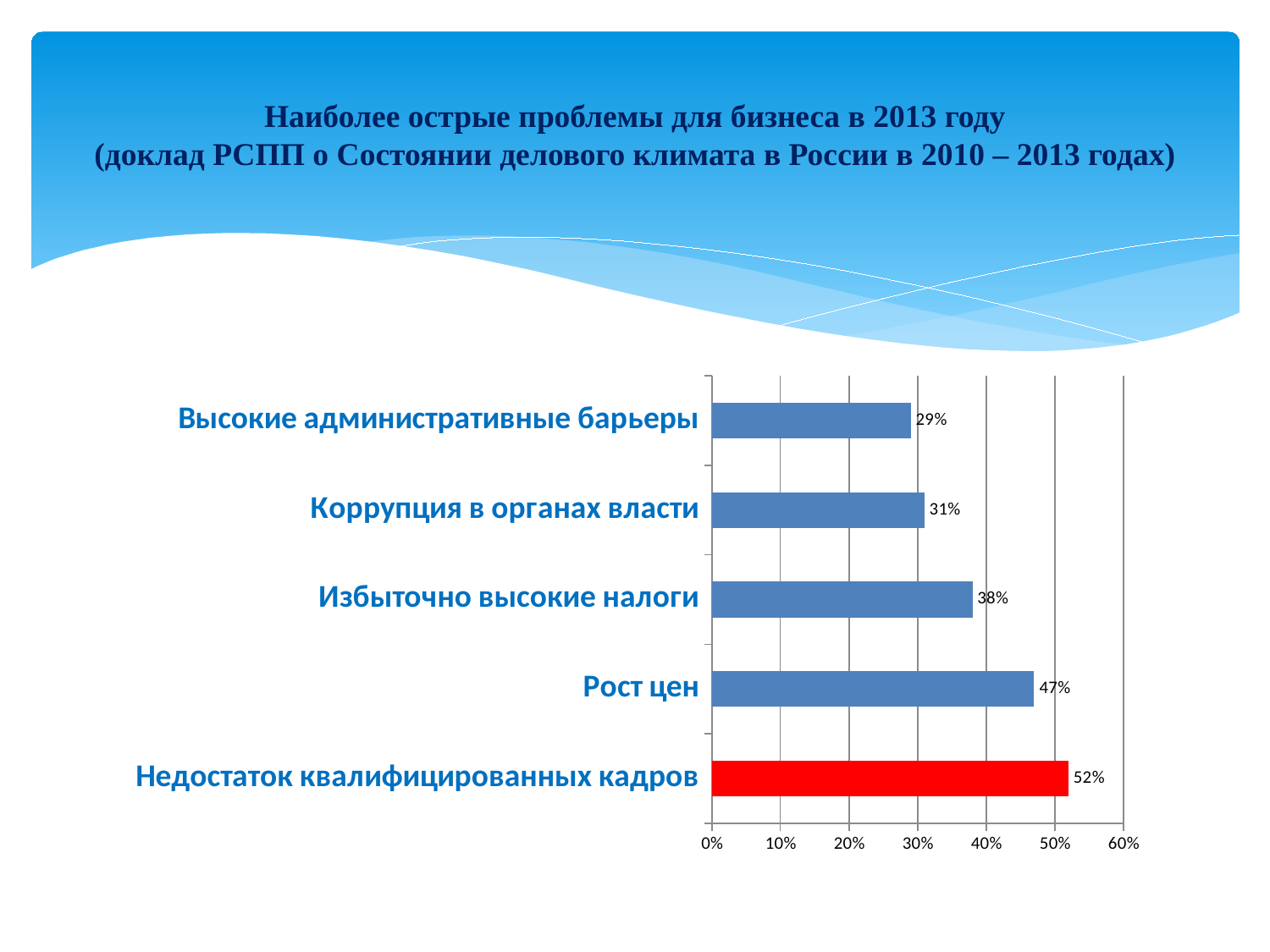
Which bar is coloured red rather than blue? Недостаток квалифицированных кадров What kind of chart is shown on the slide? Bar chart What is the value for Высокие административные барьеры? 29% How many categories are shown in the chart? 5 What is the value for Избыточно высокие налоги? 38% What is the value for Недостаток квалифицированных кадров? 52% Which category has the lowest value? Высокие административные барьеры What is the value for Рост цен? 47% Which is larger: the value for Избыточно высокие налоги or the value for Коррупция в органах власти? Избыточно высокие налоги What is the difference between the values for Недостаток квалифицированных кадров and Рост цен? 5% What is the value for Коррупция в органах власти? 31% Which category has the highest value? Недостаток квалифицированных кадров